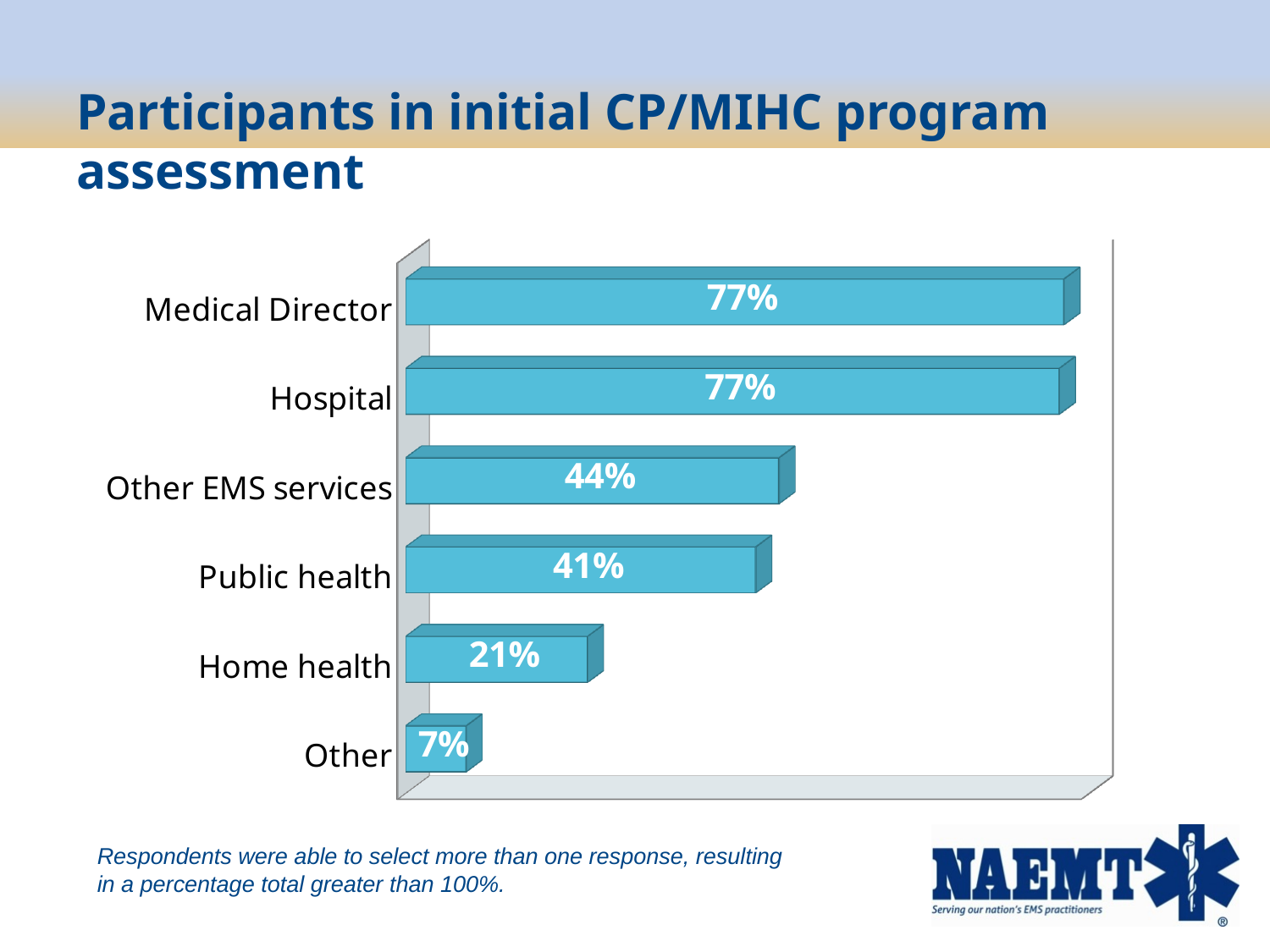
What is the difference between the values for Hospital and Home health? 56% What is the value shown for Home health? 21% What is the value shown for Hospital? 77% What is the value shown for Public health? 41% How many categories are shown in the chart? 6 Which is larger, the value for Home health or the value for Other? Home health Which category has the lowest value? Other What is the title of the slide? Participants in initial CP/MIHC program assessment What is the value shown for Other EMS services? 44% What percentage of respondents selected Medical Director as a participant in the initial CP/MIHC program assessment? 77% What is the difference between the values for Other EMS services and Public health? 3% What kind of chart is shown on the slide? Bar chart